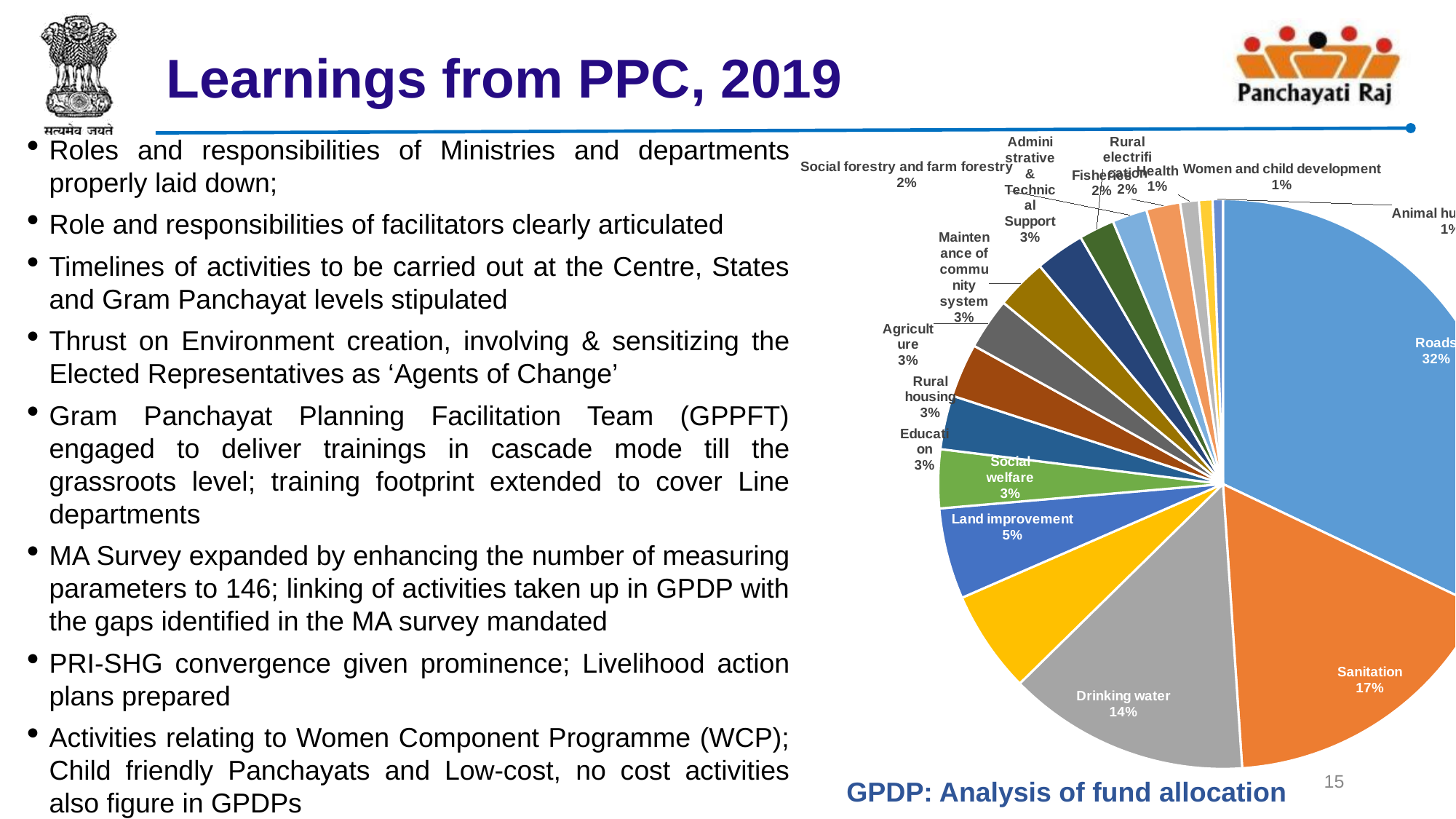
What share of fund allocation goes to Drinking water? 14% Which receives a larger share, Drinking water or Land improvement? Drinking water What share of fund allocation goes to Roads? 32% What share of fund allocation goes to Social welfare? 3% What share of fund allocation goes to Sanitation? 17% What is the difference in share between Roads and Sanitation? 15% What share of fund allocation goes to Land improvement? 5% What kind of chart is shown on the slide? pie chart What share of fund allocation goes to Social forestry and farm forestry? 2% Which category receives the largest share of fund allocation? Roads What is the title of the chart on the slide? GPDP: Analysis of fund allocation What is the combined share of Roads, Sanitation and Drinking water? 63%